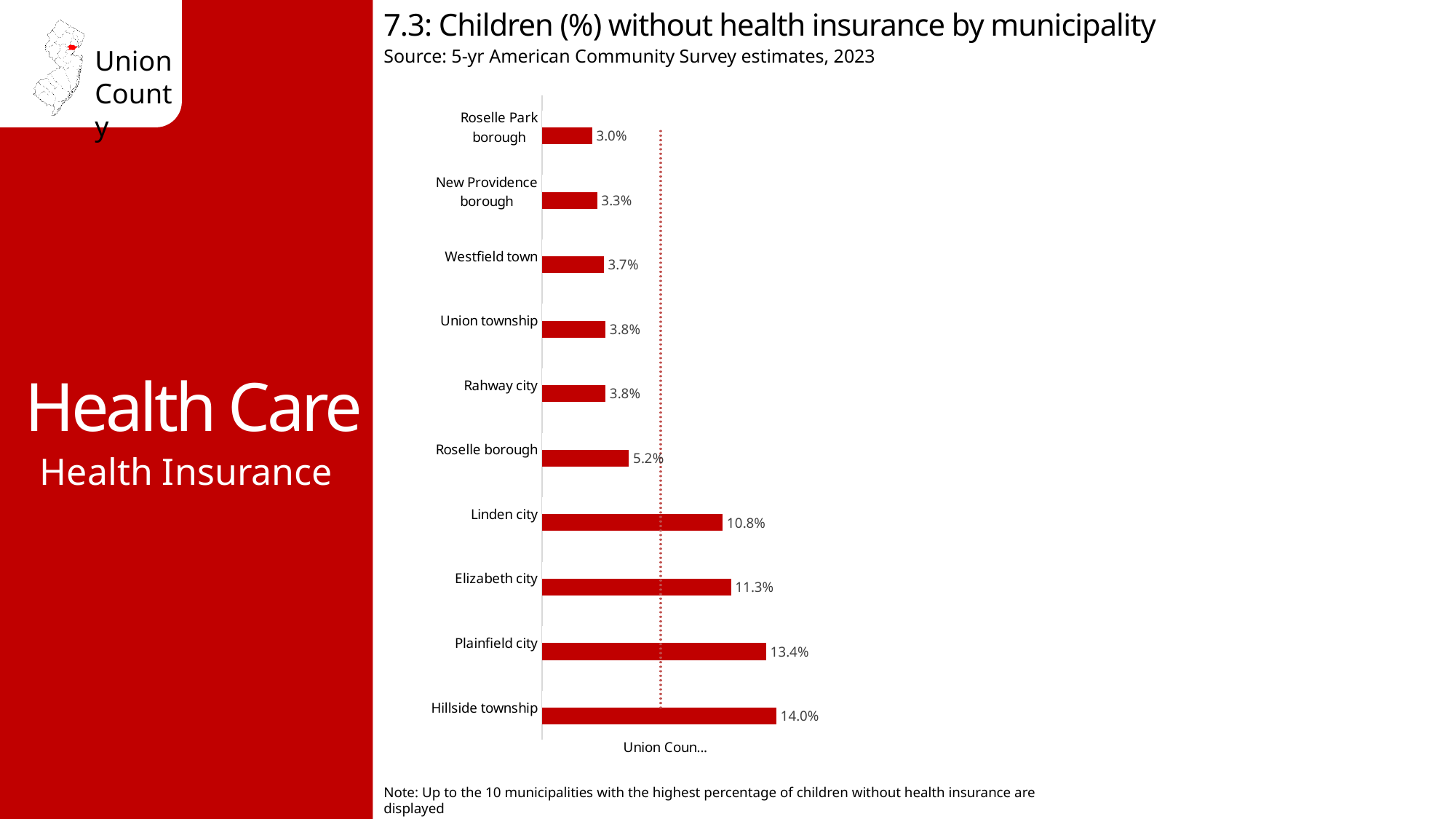
What percentage of children are without health insurance in Hillside township? 14.0% What is the difference between the values for Hillside township and Plainfield city? 0.6% What is the title of the chart? 7.3: Children (%) without health insurance by municipality What percentage is shown for Roselle borough? 5.2% What is the difference between the values for Elizabeth city and Roselle Park borough? 8.3% Which municipality has the lowest percentage of children without health insurance? Roselle Park borough Which has a higher percentage of children without health insurance, Elizabeth city or Linden city? Elizabeth city Which has a lower value, Westfield town or Roselle borough? Westfield town How many municipalities are shown in the chart? 10 What kind of chart is shown on the slide? Bar chart What is the value shown for Linden city? 10.8% Which municipality has the highest percentage of children without health insurance? Hillside township